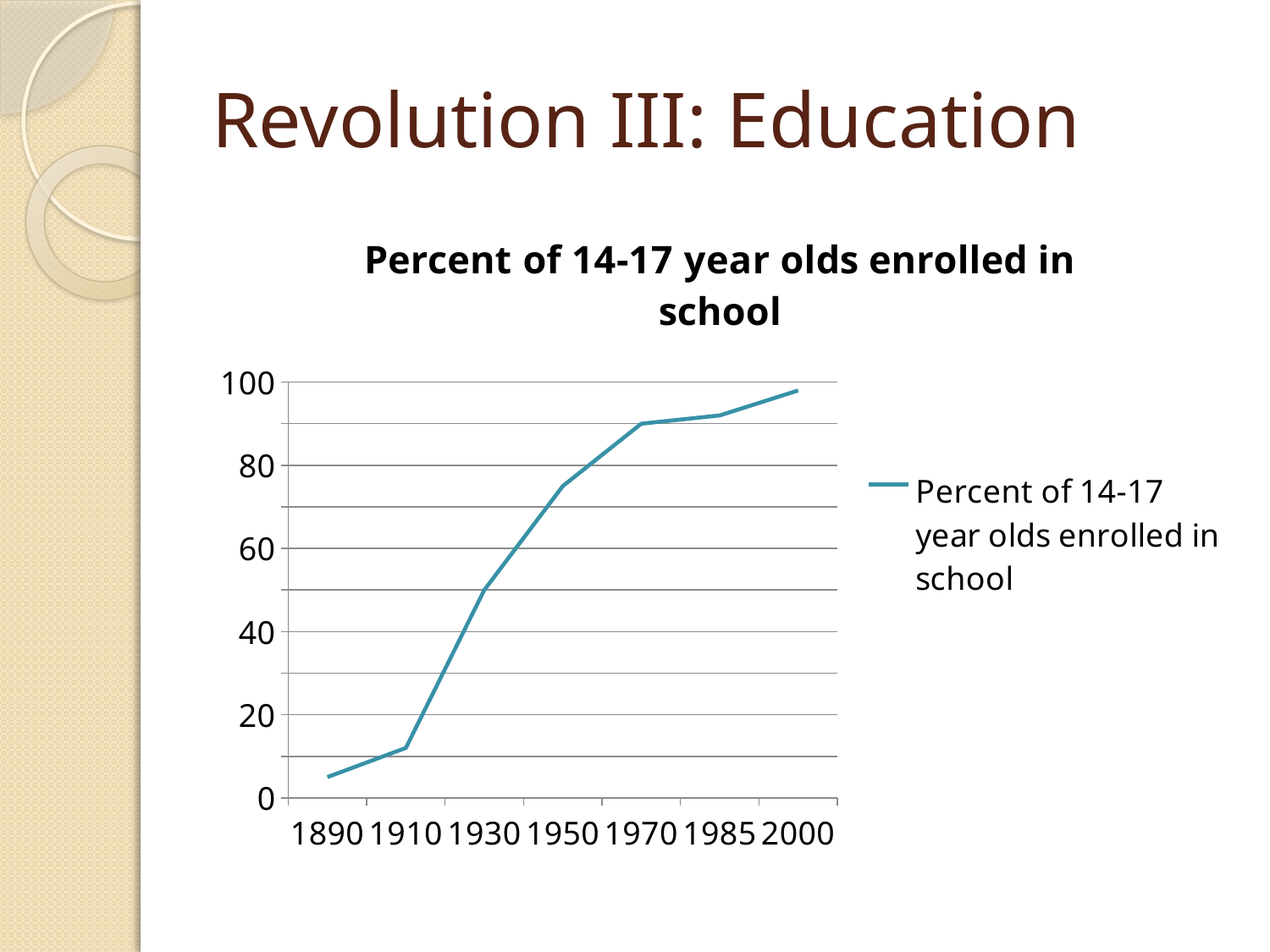
How many series does the legend list? 1 Is the value for 1890 greater or less than 20? less Which year has the lowest percent of 14-17 year olds enrolled in school? 1890 What is the title of the chart? Percent of 14-17 year olds enrolled in school Which is larger, the value for 1930 or the value for 1950? 1950 Which year has the highest percent of 14-17 year olds enrolled in school? 2000 What kind of chart is shown on the slide? line chart Is the value for 1910 greater or less than 20? less Do the values rise or fall from 1890 to 2000? rise Is the value for 1950 greater or less than 60? greater How many years are plotted along the x axis? 7